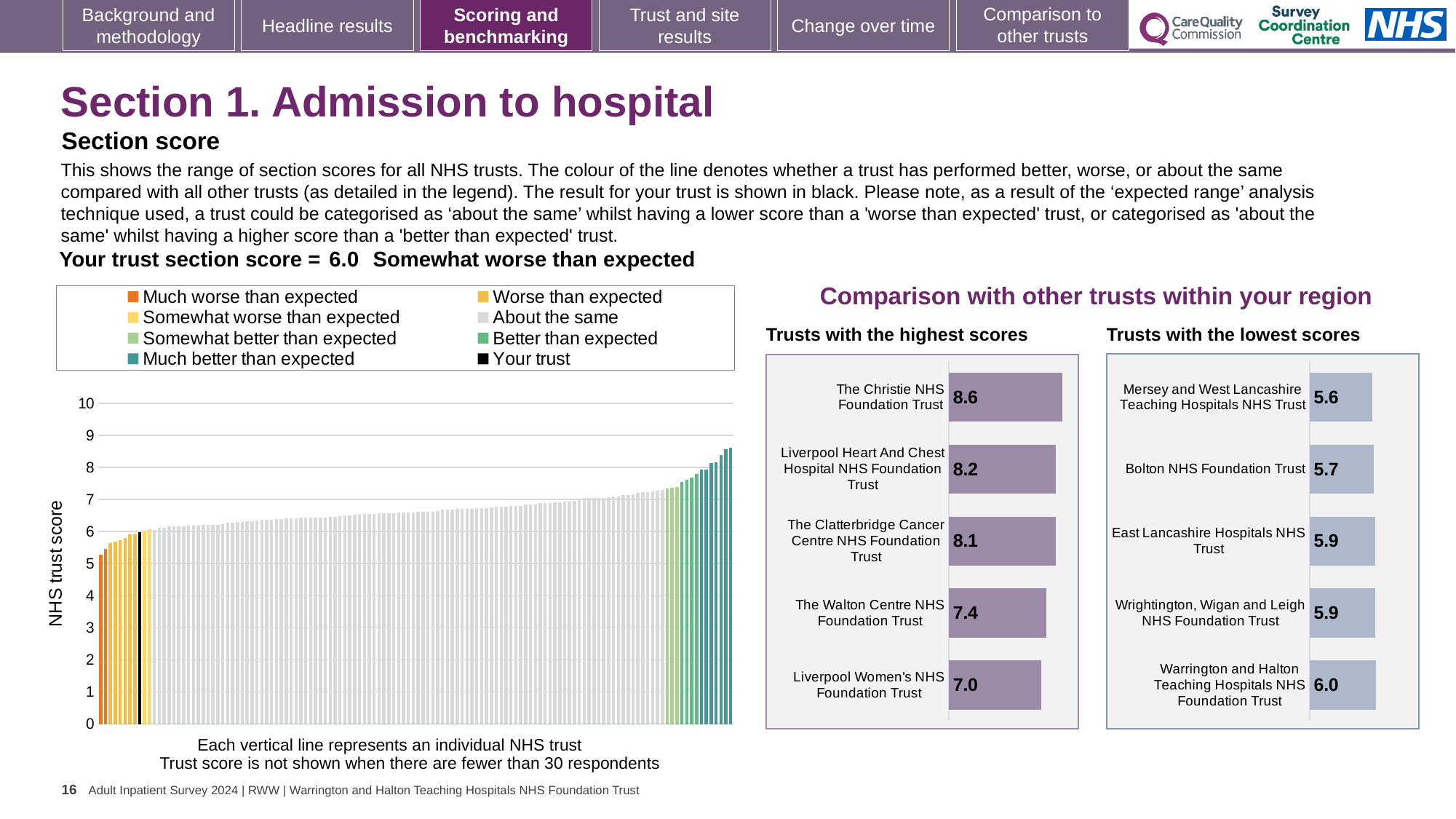
In the 'Trusts with the highest scores' chart, which trust has the lowest score shown? Liverpool Women's NHS Foundation Trust In the 'Trusts with the lowest scores' chart, what is the score for Bolton NHS Foundation Trust? 5.7 What kind of chart is the large chart on the left showing NHS trust scores? Bar chart In the large chart on the left, is the value of the tallest bar greater or less than 8? greater In the 'Trusts with the highest scores' chart, what is the score for The Christie NHS Foundation Trust? 8.6 In the 'Trusts with the highest scores' chart, how many trusts are listed? 5 In the 'Trusts with the lowest scores' chart, which trust has the lowest score? Mersey and West Lancashire Teaching Hospitals NHS Trust In the 'Trusts with the lowest scores' chart, what is the difference between the scores of Warrington and Halton Teaching Hospitals NHS Foundation Trust and Mersey and West Lancashire Teaching Hospitals NHS Trust? 0.4 In the large chart on the left, do the trust scores rise or fall from left to right? Rise How many entries does the legend of the large chart on the left list? 8 In the 'Trusts with the highest scores' chart, what is the difference between the scores of The Christie NHS Foundation Trust and Liverpool Women's NHS Foundation Trust? 1.6 In the 'Trusts with the lowest scores' chart, which has the higher score: Warrington and Halton Teaching Hospitals NHS Foundation Trust or Mersey and West Lancashire Teaching Hospitals NHS Trust? Warrington and Halton Teaching Hospitals NHS Foundation Trust